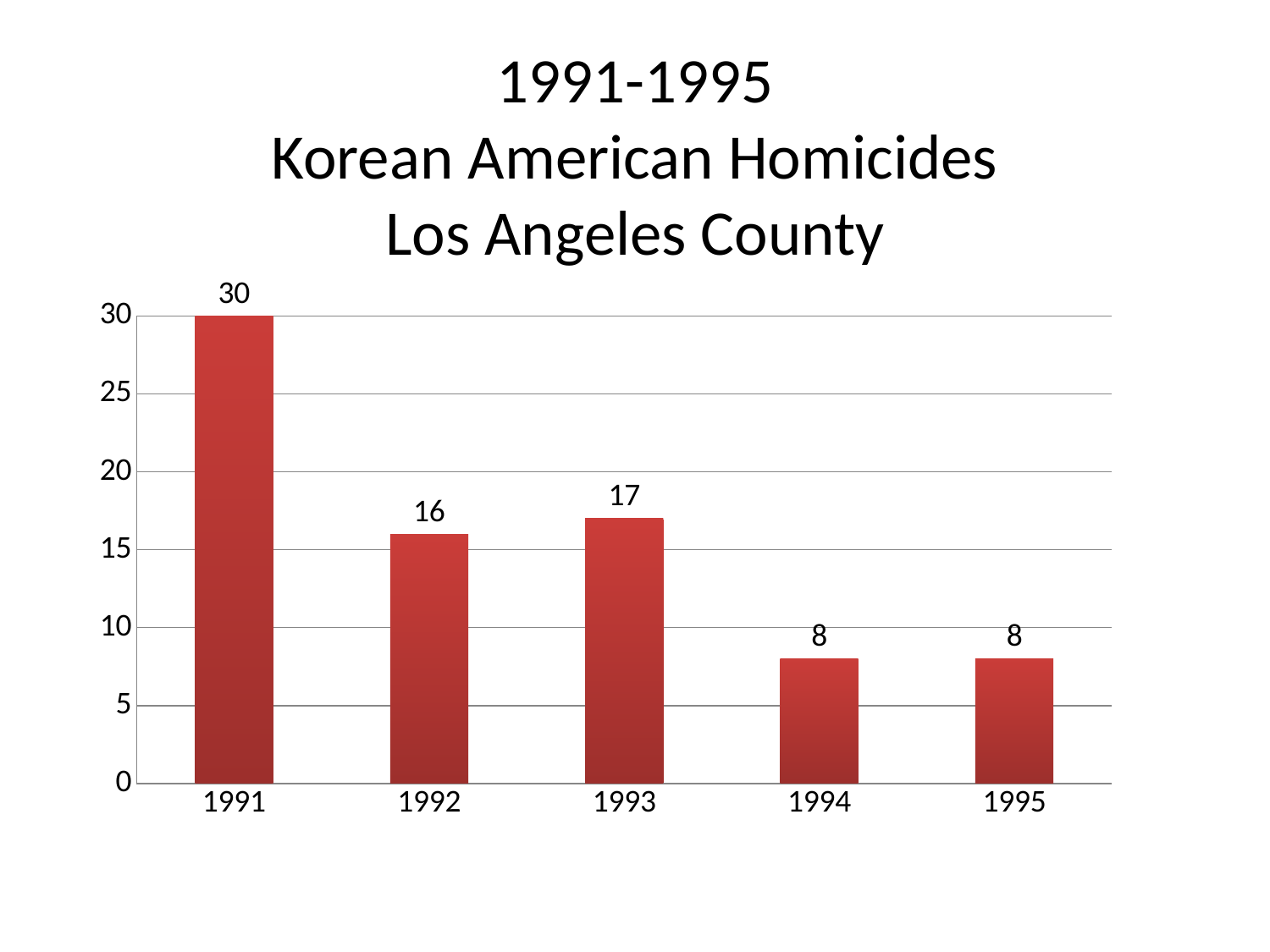
What is the value for 1991? 30 What is the difference between the values for 1991 and 1992? 14 What is the title of the chart? 1991-1995 Korean American Homicides Los Angeles County What is the difference between the values for 1993 and 1994? 9 Is the value for 1991 greater or less than 25? greater Do the values generally rise or fall from 1991 to 1995? fall How many years are shown on the x axis? 5 Which year has the highest value? 1991 What is the value for 1993? 17 Which is larger, the value for 1992 or the value for 1993? 1993 What kind of chart is shown on the slide? bar chart What is the value for 1995? 8